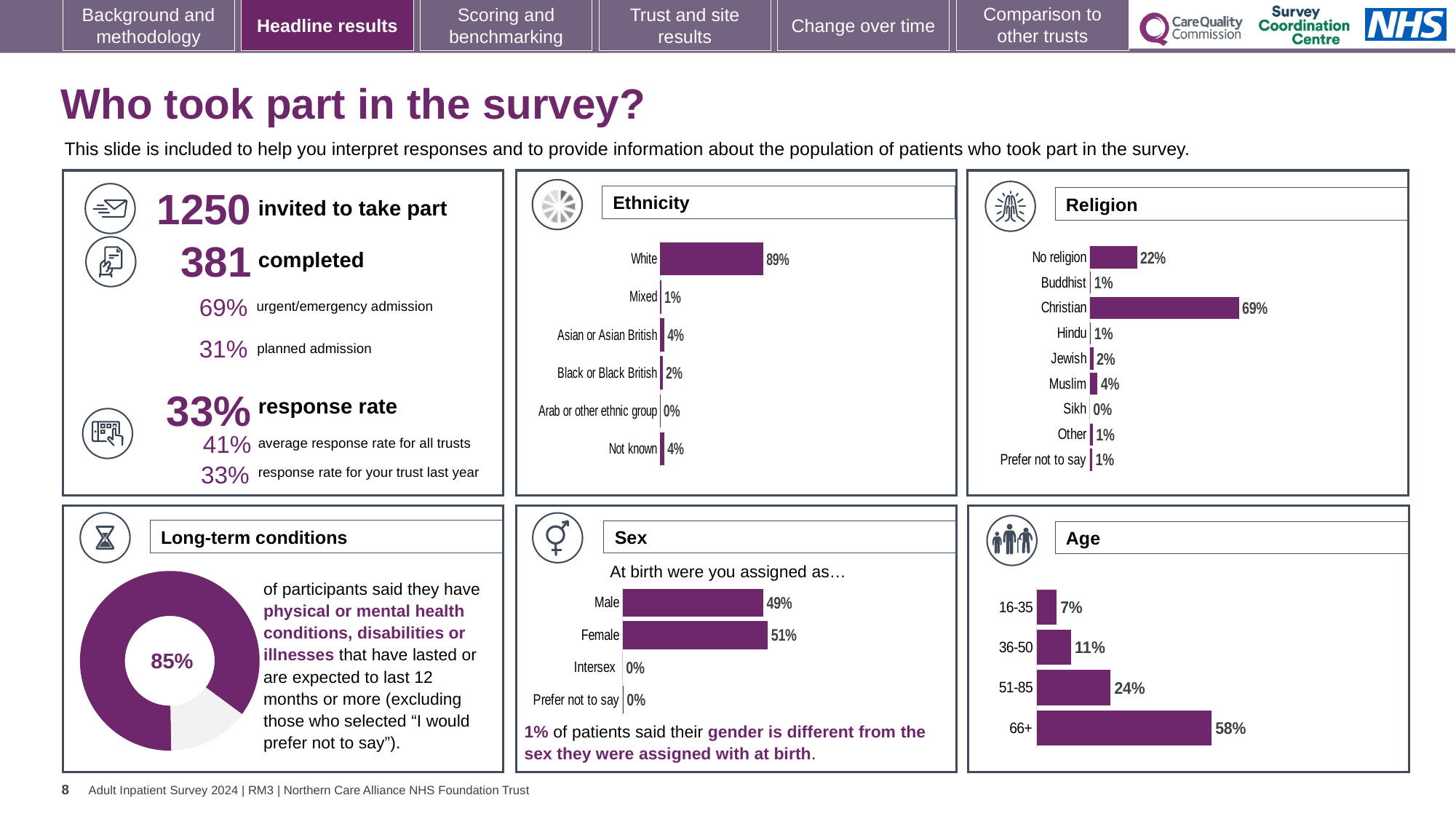
In the Religion chart, which category has the highest value? Christian In the Religion chart, what is the value for No religion? 22% How many age groups are shown in the Age chart? 4 In the Age chart, what is the value for 36-50? 11% In the Ethnicity chart, what percentage of respondents were White? 89% In the Sex chart, which is larger, Male or Female? Female In the Long-term conditions chart, what share of participants said they have long-term conditions? 85% In the Ethnicity chart, which category has the lowest value? Arab or other ethnic group In the Age chart, what is the difference between the 66+ and 51-85 values? 34% In the Age chart, do the values rise or fall as age increases from 16-35 to 66+? Rise How many categories are shown in the Religion chart? 9 What kind of chart is the Long-term conditions chart? Doughnut chart